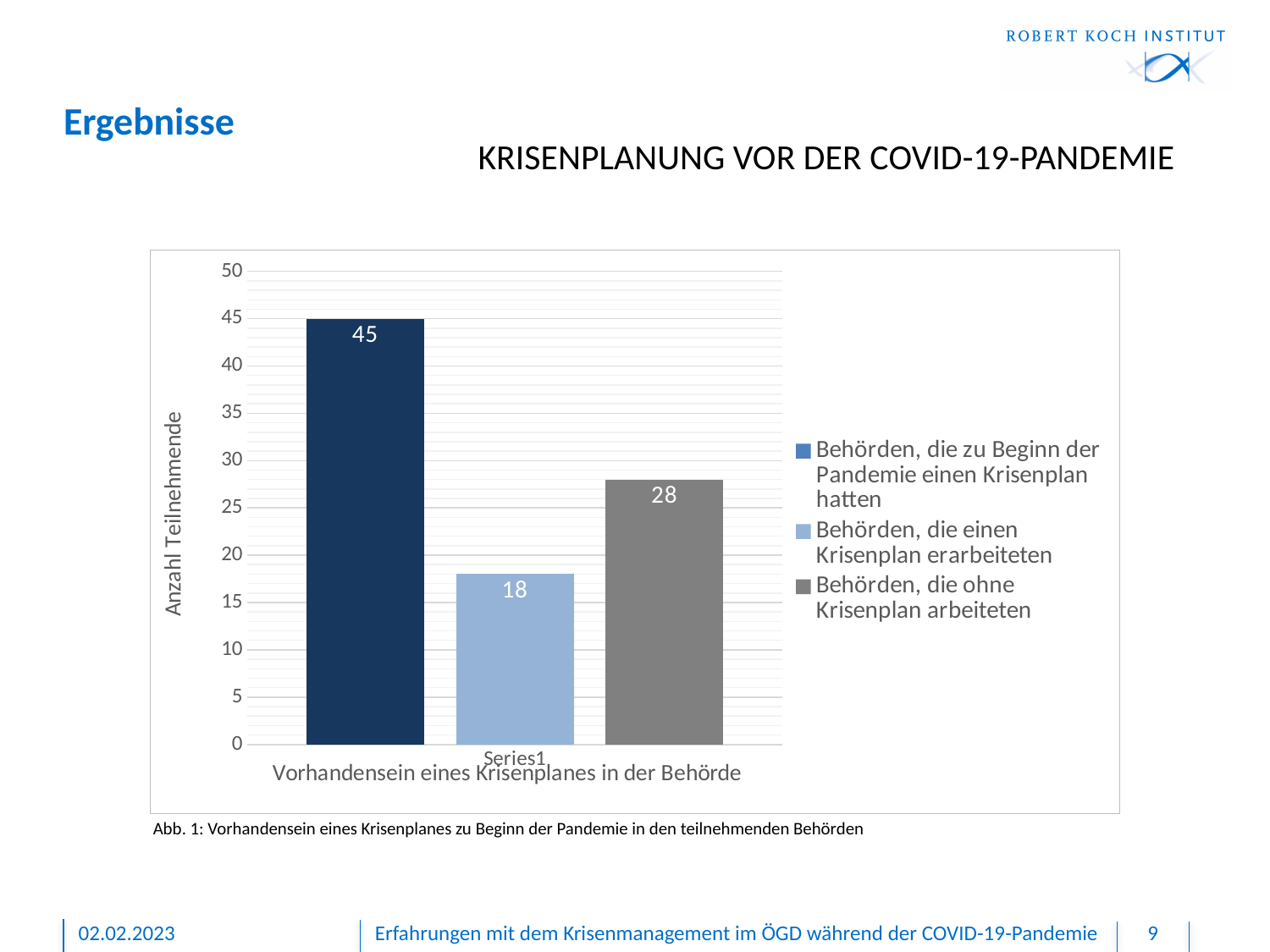
What kind of chart is shown on the slide? bar chart What is the difference between the value for 'Behörden, die zu Beginn der Pandemie einen Krisenplan hatten' and 'Behörden, die ohne Krisenplan arbeiteten'? 17 Which series has the lowest value? Behörden, die einen Krisenplan erarbeiteten Is the value for 'Behörden, die einen Krisenplan erarbeiteten' greater or less than 20? less What is the difference between the value for 'Behörden, die ohne Krisenplan arbeiteten' and 'Behörden, die einen Krisenplan erarbeiteten'? 10 What is the value for 'Behörden, die einen Krisenplan erarbeiteten'? 18 What is the value for 'Behörden, die zu Beginn der Pandemie einen Krisenplan hatten'? 45 What is the label of the vertical axis? Anzahl Teilnehmende How many series does the legend list? 3 Which is larger: the value for 'Behörden, die einen Krisenplan erarbeiteten' or 'Behörden, die ohne Krisenplan arbeiteten'? Behörden, die ohne Krisenplan arbeiteten What is the value for 'Behörden, die ohne Krisenplan arbeiteten'? 28 Which series has the highest value? Behörden, die zu Beginn der Pandemie einen Krisenplan hatten